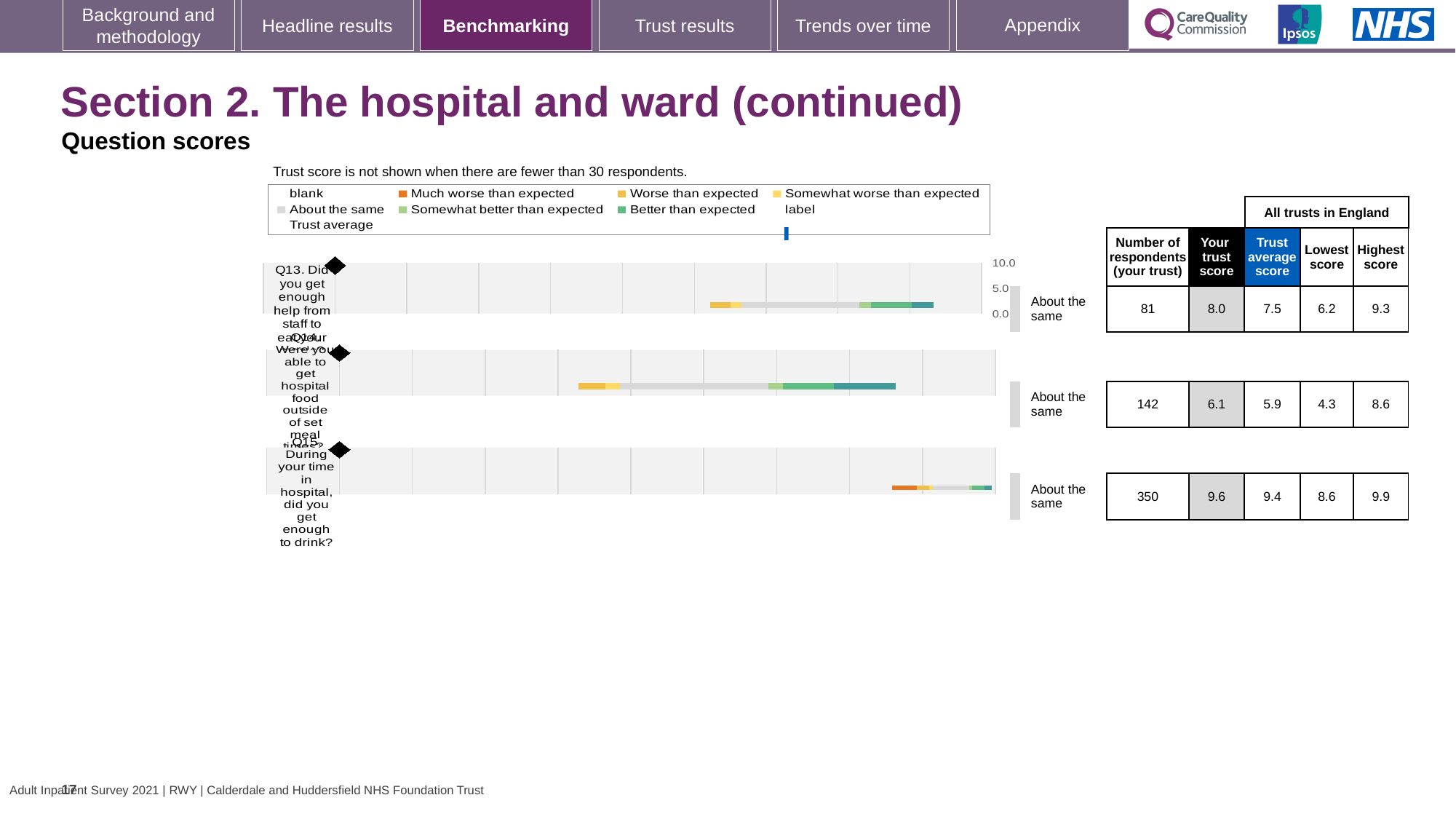
What is the difference between the highest and lowest scores across all trusts in England for Q15? 1.3 How many questions are plotted in the chart? 3 What benchmark rating is shown for Q13? About the same Which question has the highest trust score? Q15 What is the trust score for Q13 (Did you get enough help from staff to eat your meals)? 8.0 What is the difference between the trust score and the trust average score for Q13? 0.5 For Q14, which is larger: the trust score or the trust average score? Trust score What is the highest score across all trusts in England for Q14? 8.6 Which question has the lowest trust score? Q14 What kind of chart is used to show the question scores on this slide? Bar chart How many respondents answered Q14 (Were you able to get hospital food outside of set meal times)? 142 What is the trust average score for Q15 (During your time in hospital, did you get enough to drink)? 9.4